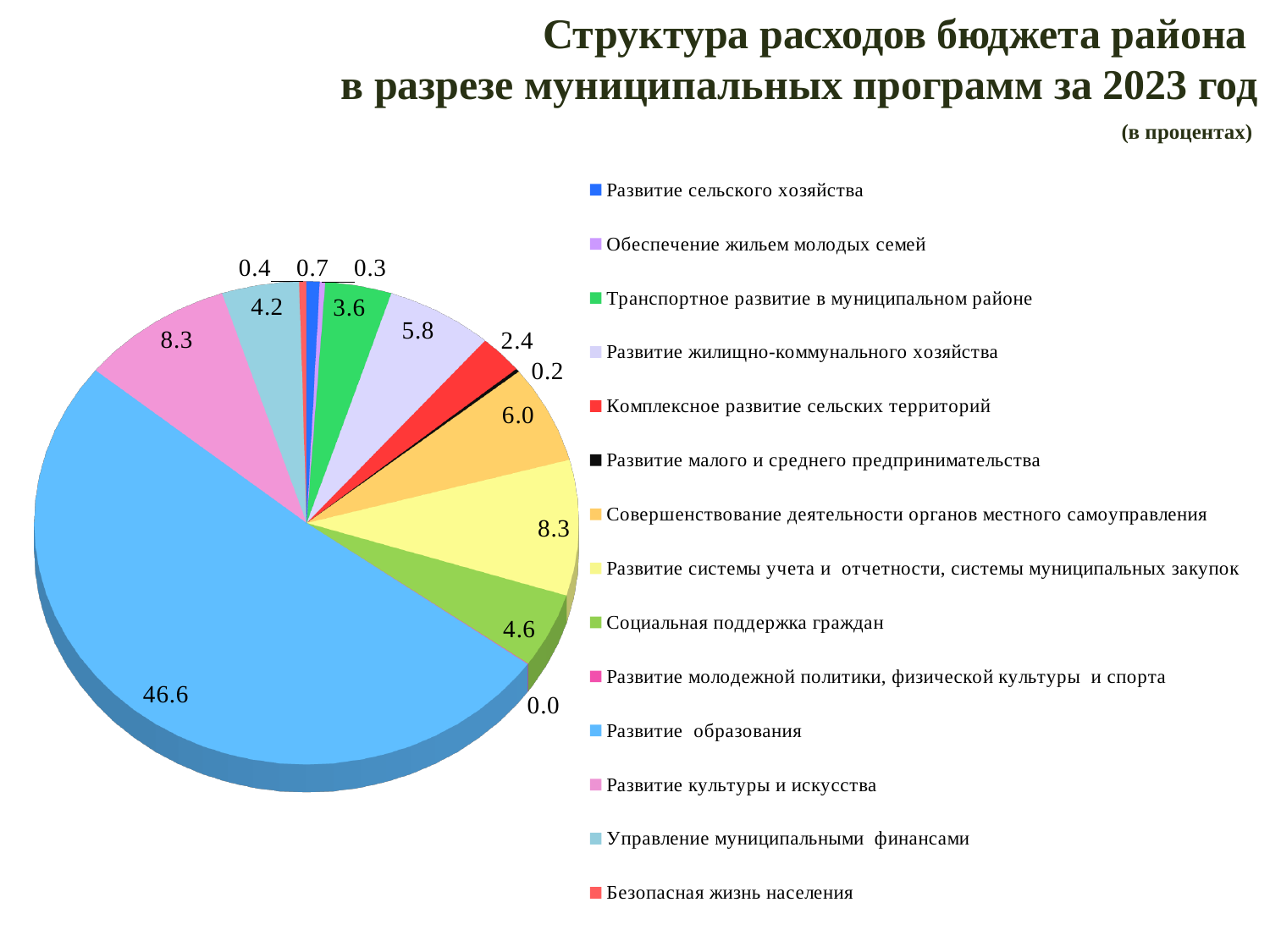
What is the value for Развитие образования? 46.6 What is the value for Социальная поддержка граждан? 4.6 Which is larger: the value for Транспортное развитие в муниципальном районе or the value for Комплексное развитие сельских территорий? Транспортное развитие в муниципальном районе What unit is stated under the chart title? в процентах What is the value for Управление муниципальными финансами? 4.2 Which program has the largest share of the pie? Развитие образования What is the value for Развитие жилищно-коммунального хозяйства? 5.8 What is the difference between the values for Развитие культуры и искусства and Управление муниципальными финансами? 4.1 Which program has the smallest share of the pie? Развитие молодежной политики, физической культуры и спорта What is the value for Совершенствование деятельности органов местного самоуправления? 6.0 How many programs are listed in the legend? 14 What kind of chart is shown on the slide? pie chart